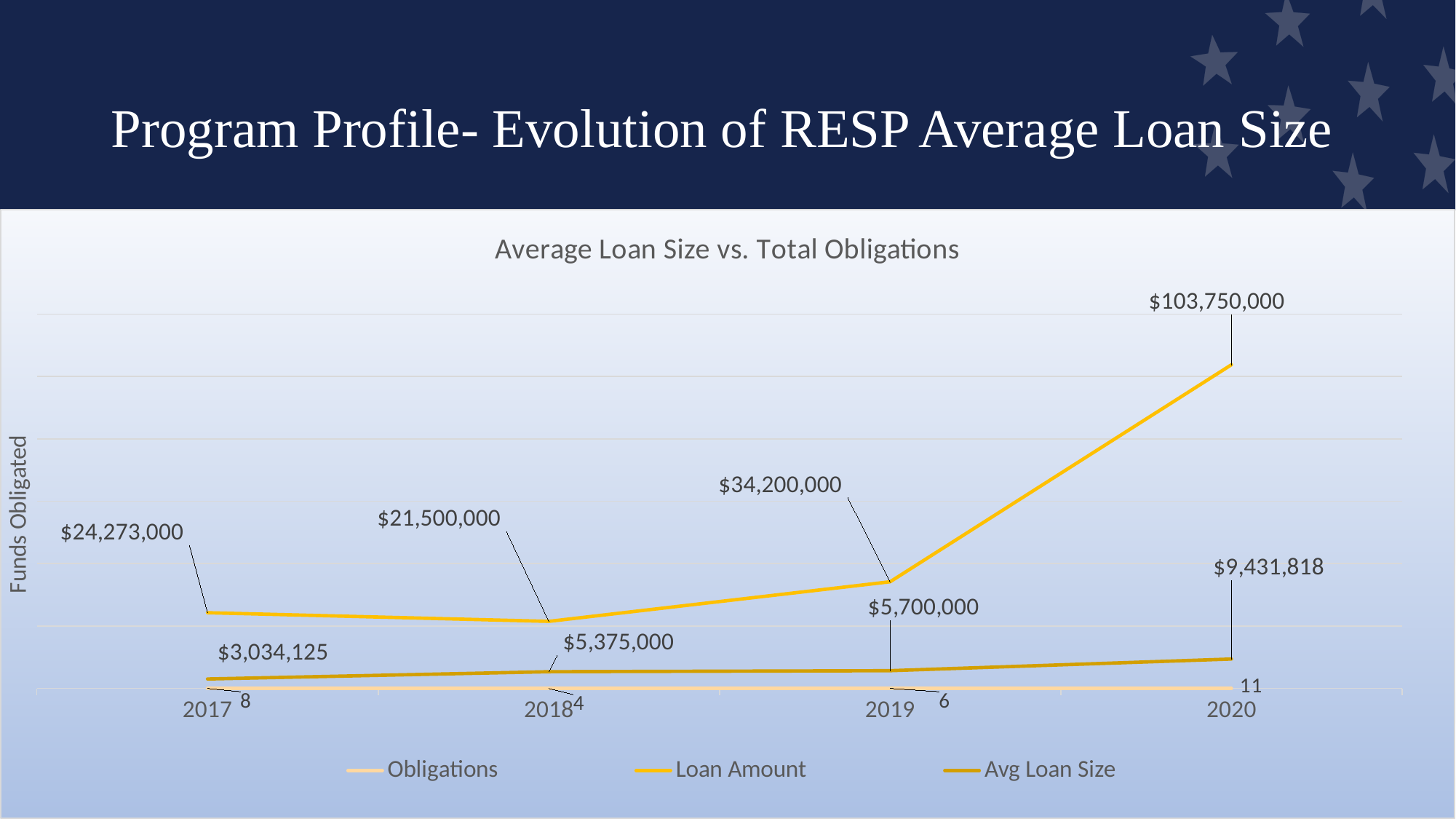
What is the Obligations value for 2017? 8 What is the Loan Amount value for 2020? $103,750,000 What type of chart is shown on the slide? line chart What is the title of the chart? Average Loan Size vs. Total Obligations Does the Avg Loan Size rise or fall from 2017 to 2020? rise What is the difference between the Loan Amount in 2020 and in 2019? $69,550,000 In which year is the Loan Amount lowest? 2018 How many series does the legend list? 3 How many years are plotted on the x axis? 4 What is the Avg Loan Size value for 2018? $5,375,000 Which is larger, the Avg Loan Size in 2019 or in 2018? 2019 In which year is the Avg Loan Size highest? 2020